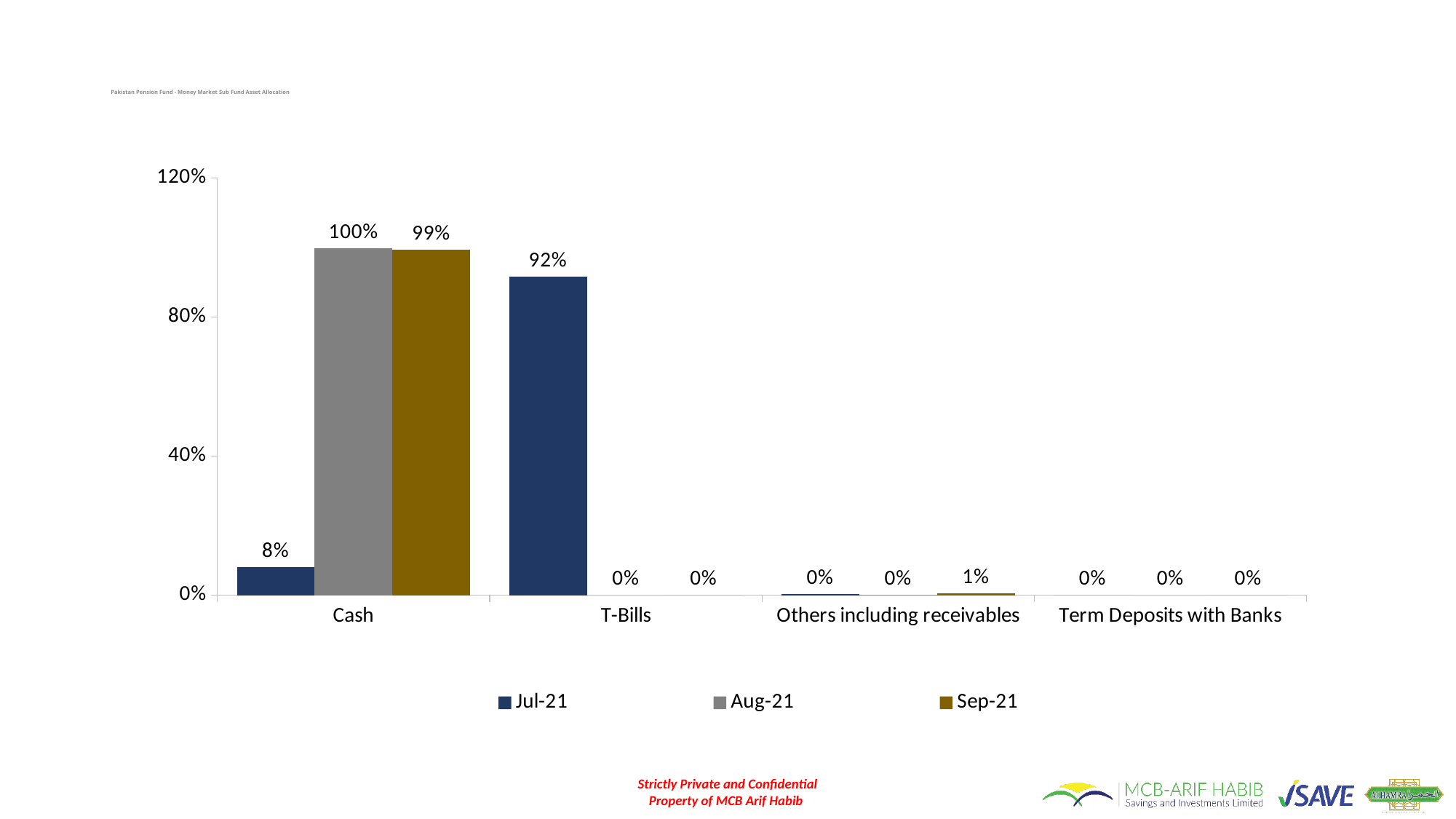
Which is larger for Cash: the Aug-21 value or the Sep-21 value? Aug-21 How many categories are shown on the x axis? 4 What is the Sep-21 value for Others including receivables? 1% What kind of chart is shown on the slide? Bar chart How many series does the legend list? 3 Which category has the highest Jul-21 value? T-Bills Is the Jul-21 value for T-Bills greater or less than 80%? greater Which series is shown in grey in the legend? Aug-21 What is the Sep-21 value for T-Bills? 0% What is the Aug-21 value for Cash? 100% What is the Jul-21 value for Cash? 8% What is the difference between the Jul-21 value for T-Bills and the Jul-21 value for Cash? 84%